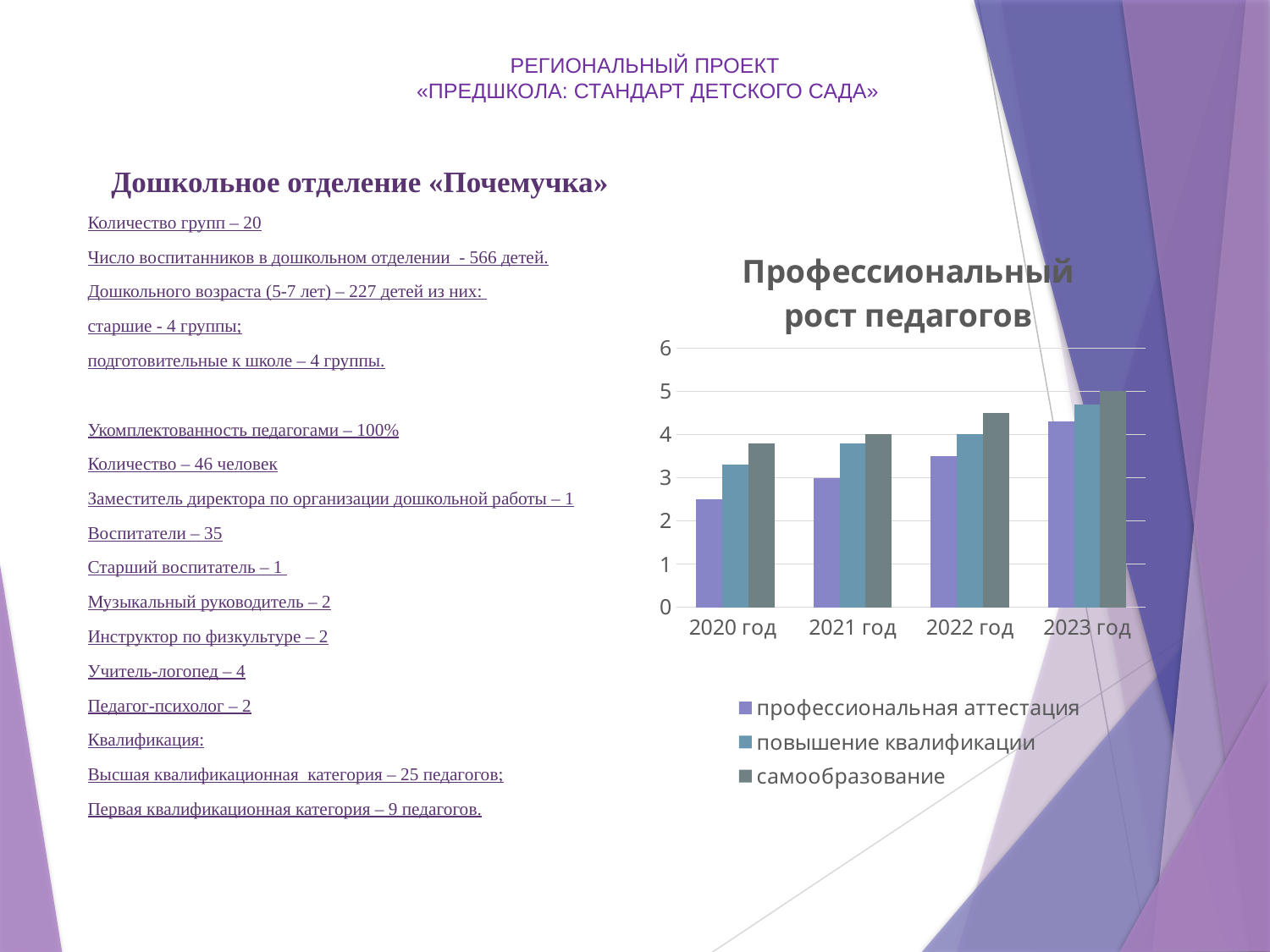
Which series is shown in the darkest (grey-green) colour in the chart? самообразование Is the value for самообразование in 2020 год greater or less than 4? less What is the title of the chart? Профессиональный рост педагогов How many series does the chart legend list? 3 Do the values for повышение квалификации rise or fall from 2020 год to 2023 год? rise How many years (categories) are shown on the x axis of the chart? 4 Which is larger: самообразование in 2022 год or самообразование in 2020 год? самообразование in 2022 год What kind of chart is shown on the slide? bar chart Is the value for профессиональная аттестация in 2020 год greater or less than 3? less Which year has the lowest value for профессиональная аттестация? 2020 год Which year has the highest value for самообразование? 2023 год Is the value for повышение квалификации in 2023 год greater or less than 4? greater